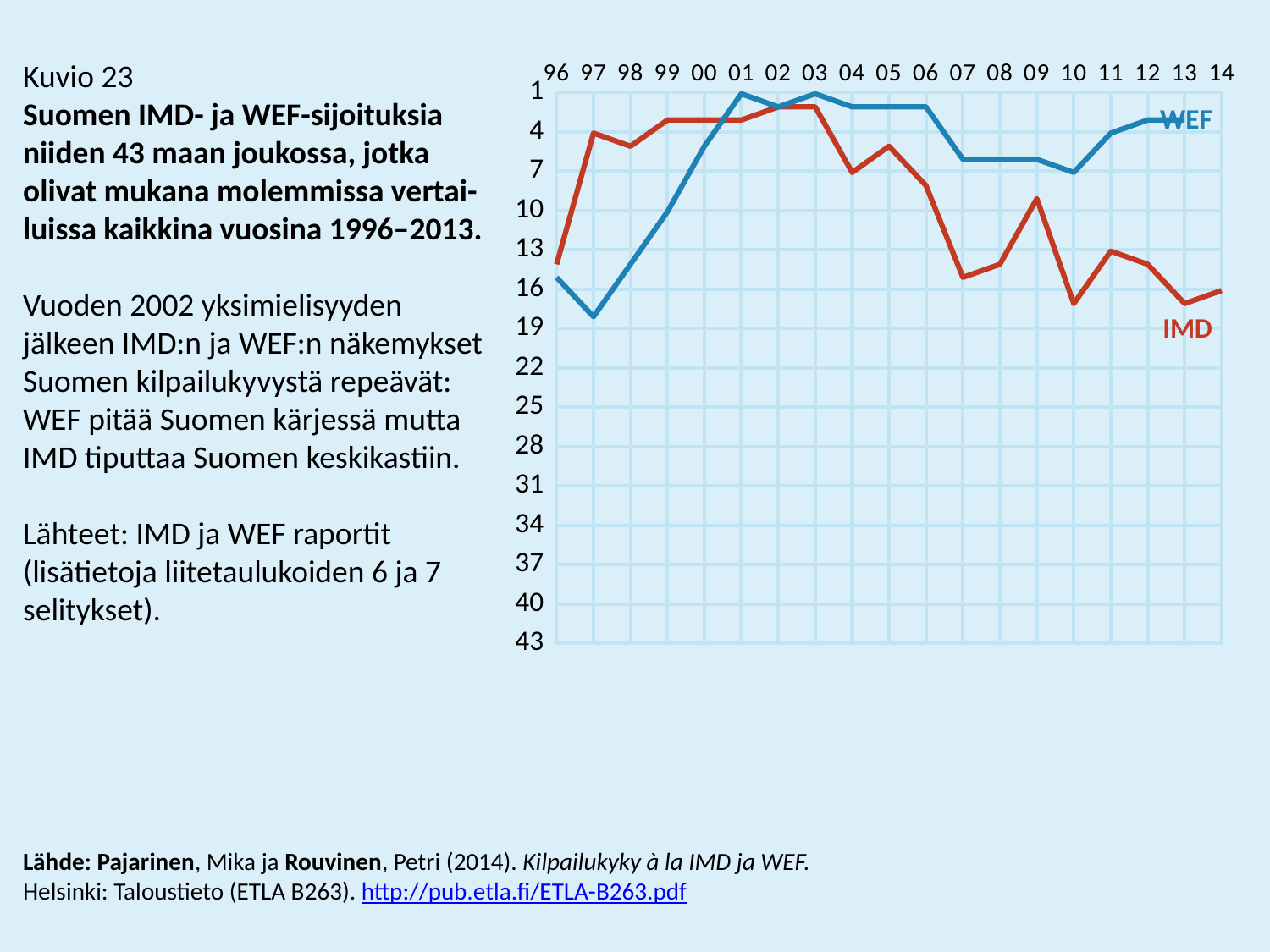
What is the WEF value for the year 01? 1 What colour is the WEF line in the chart? blue What kind of chart is shown on the slide? line chart In which year does the WEF line reach its lowest numeric value (rank 1)? 01 and 03 In the year 97, which series has the larger numeric value, WEF or IMD? WEF Is the WEF value for the year 97 greater or less than 13? greater What is the IMD value for the year 97? 4 How many series are plotted in the chart? 2 How many years are shown along the x axis of the chart? 19 Is the IMD value for the year 10 greater or less than 13? greater What is the WEF value for the year 10? 7